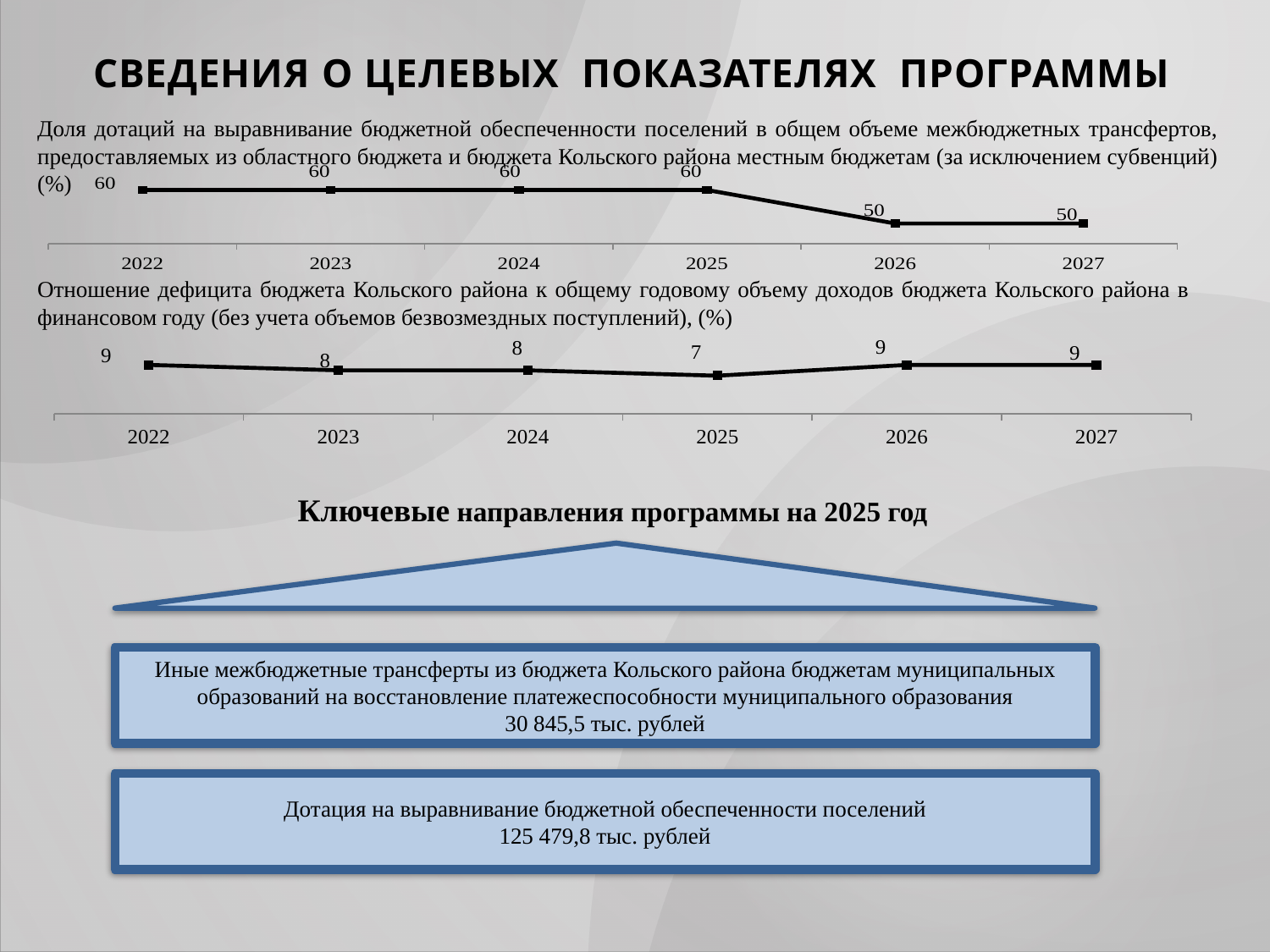
How many years are plotted in the top chart (share of equalization subsidies)? 6 In the top chart (share of equalization subsidies), what is the difference between the 2025 and 2027 values? 10 How many data points are plotted in the bottom chart (budget deficit ratio)? 6 In the bottom chart (budget deficit ratio), what is the difference between the 2026 and 2025 values? 2 In the top chart (share of equalization subsidies), what is the value for 2022? 60 In the top chart (share of equalization subsidies), what is the value for 2026? 50 What type of chart is the top chart (share of equalization subsidies)? line chart In the bottom chart (budget deficit ratio), which is larger, the value for 2022 or the value for 2025? 2022 In the top chart (share of equalization subsidies), do the values rise or fall from 2022 to 2027? fall In the bottom chart (budget deficit ratio), what is the value for 2023? 8 In the bottom chart (budget deficit ratio), which year has the lowest value? 2025 In the bottom chart (budget deficit ratio), what is the value for 2025? 7